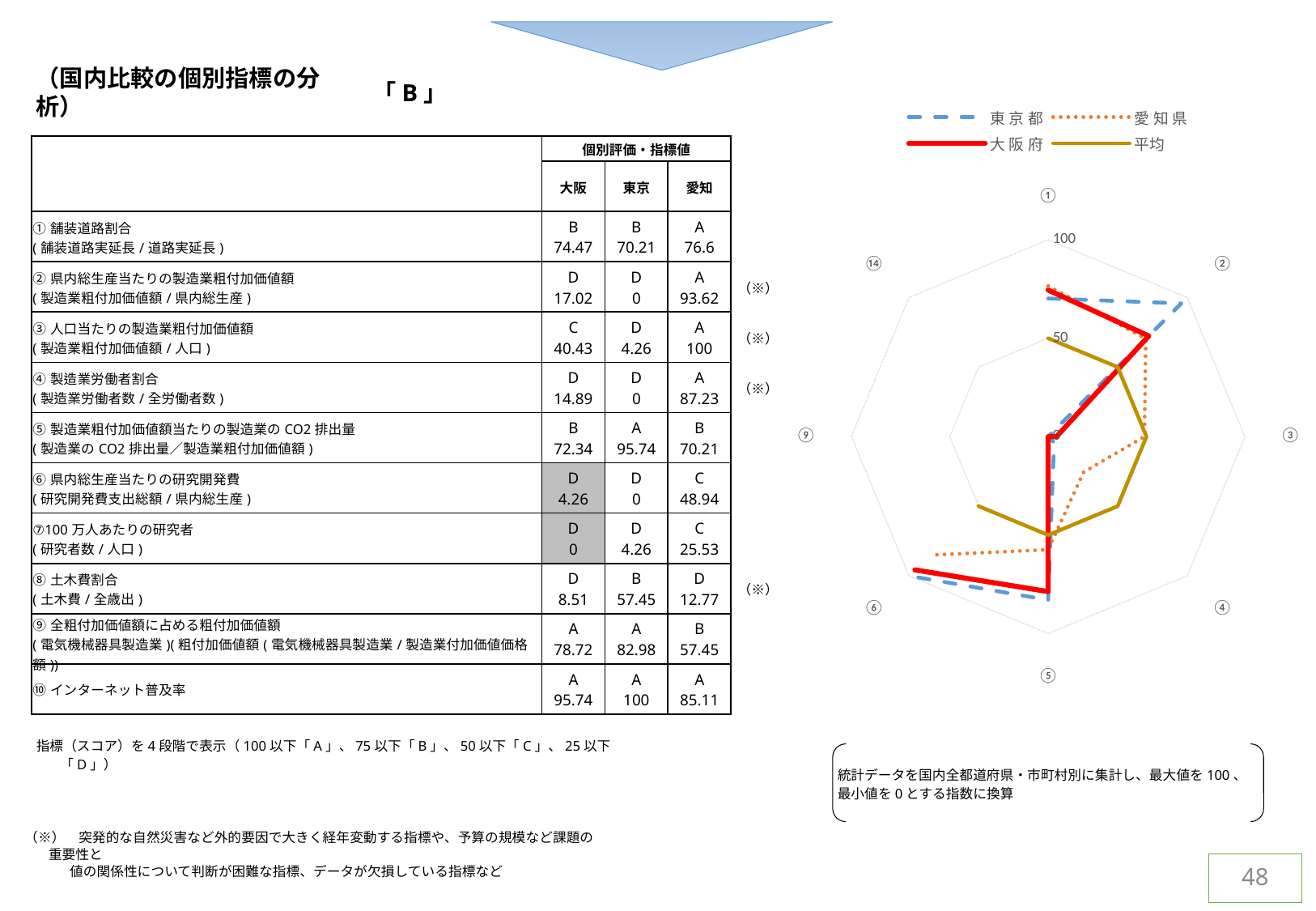
In the radar chart, is the value for 大阪府 on axis ① greater or less than 50? greater In the radar chart, is the value for 愛知県 on axis ⑥ greater or less than 50? greater Which series are listed in the legend of the radar chart? 東京都, 愛知県, 大阪府, 平均 What kind of chart is shown on the right side of the slide? radar chart In the radar chart, on axis ⑥, which is larger: 大阪府 or 平均? 大阪府 In the radar chart, on axis ⑤, which is larger: 大阪府 or 平均? 大阪府 How many series does the legend of the radar chart list? 4 In the radar chart, which series is drawn as a solid red line? 大阪府 In the radar chart, is the value for 大阪府 on axis ⑤ greater or less than 50? greater